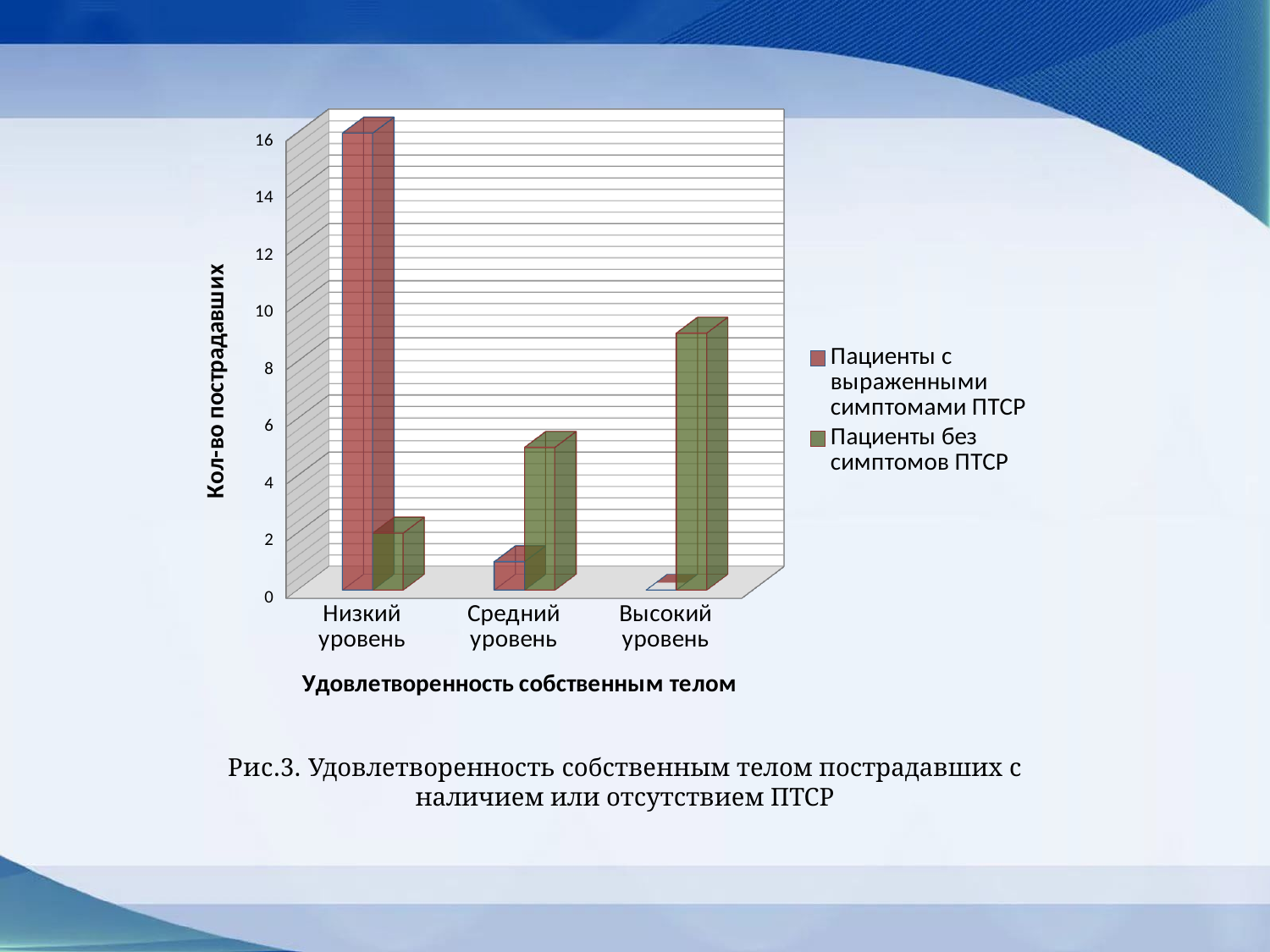
Is the value for Пациенты с выраженными симптомами ПТСР at Низкий уровень greater or less than 14? greater For which category is the value for Пациенты с выраженными симптомами ПТСР highest? Низкий уровень How many categories are shown on the x axis? 3 At Высокий уровень, which series has the larger value? Пациенты без симптомов ПТСР For which category is the value for Пациенты без симптомов ПТСР lowest? Низкий уровень Is the value for Пациенты с выраженными симптомами ПТСР at Средний уровень greater or less than 2? less Is the value for Пациенты без симптомов ПТСР at Высокий уровень greater or less than 8? greater Do the values for Пациенты без симптомов ПТСР rise or fall from Низкий уровень to Высокий уровень? rise What kind of chart is shown on the slide? Bar chart What is the title of the vertical axis? Кол-во пострадавших How many series does the legend list? 2